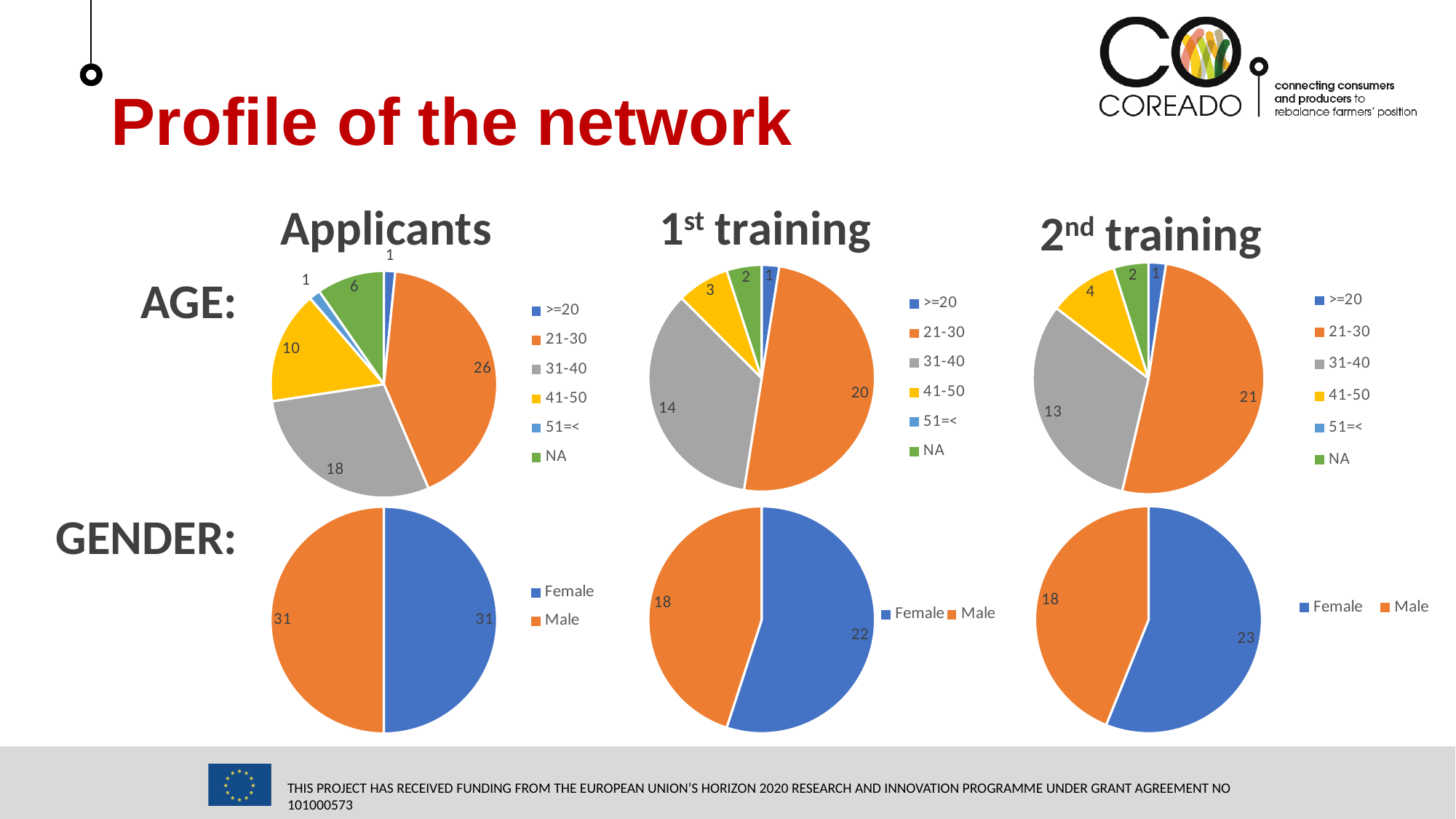
In the 2nd training GENDER pie chart, which is larger, Female or Male? Female In the 2nd training AGE pie chart, which age group has the largest slice? 21-30 In the Applicants AGE pie chart, what is the difference between the 21-30 and 31-40 values? 8 In the Applicants AGE pie chart, which age group has the largest slice? 21-30 In the 2nd training AGE pie chart, what is the value for the 41-50 age group? 4 In the Applicants GENDER pie chart, what is the value for Male? 31 In the 1st training GENDER pie chart, what is the value for Female? 22 In the Applicants AGE pie chart, what is the value for the 21-30 age group? 26 In the 1st training AGE pie chart, what is the value for the 31-40 age group? 14 What kind of chart is used for the 1st training GENDER data? Pie chart In the 2nd training GENDER pie chart, what is the difference between the Female and Male values? 5 How many entries does the legend of the Applicants AGE pie chart list? 6